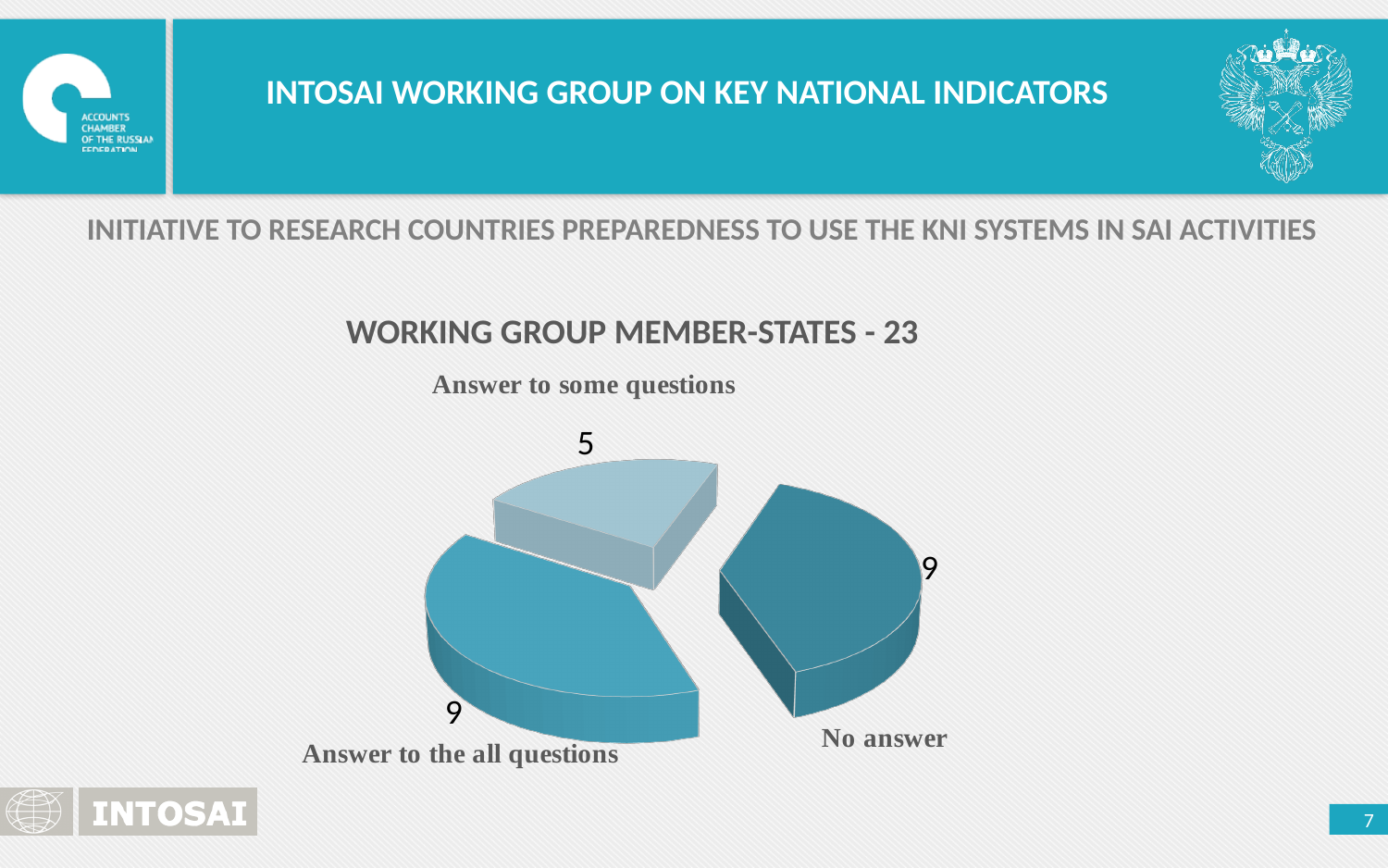
What share of the 23 member-states does the "Answer to some questions" slice represent? 5 out of 23 Which category has the smallest slice of the pie? Answer to some questions What is the value for the "Answer to the all questions" slice? 9 What is the total of all the slices in the pie chart? 23 What is the value for the "Answer to some questions" slice? 5 What is the value for the "No answer" slice? 9 What is the title shown above the pie chart? WORKING GROUP MEMBER-STATES - 23 Is the value for "Answer to the all questions" greater or less than the value for "Answer to some questions"? greater What kind of chart is shown on the slide? Pie chart Which is larger, the value for "No answer" or the value for "Answer to some questions"? No answer What is the difference between the "No answer" value and the "Answer to some questions" value? 4 How many slices does the pie chart have? 3